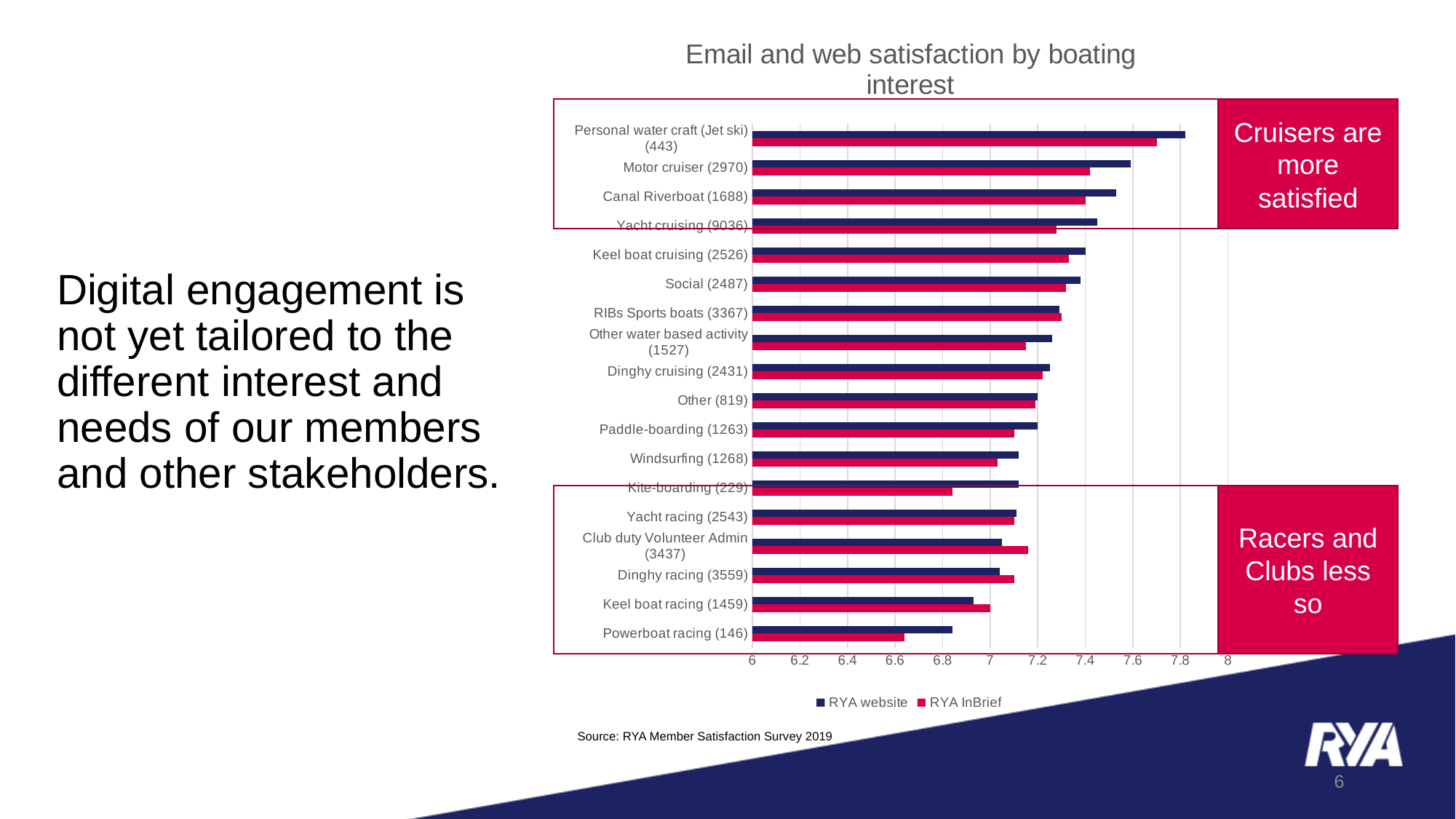
Is the RYA website value for Motor cruiser greater or less than 7.4? greater For Club duty Volunteer Admin, which series has the larger value, RYA website or RYA InBrief? RYA InBrief What is the title of the chart? Email and web satisfaction by boating interest Is the RYA InBrief value for Powerboat racing greater or less than 6.8? less Which category has the lowest RYA InBrief satisfaction score? Powerboat racing (146) Which colour represents the RYA InBrief series in the chart? Red Which category has the highest RYA website satisfaction score? Personal water craft (Jet ski) (443) Is the RYA website value for Personal water craft (Jet ski) greater or less than 7.6? greater What type of chart is shown on the slide? Bar chart How many boating interest categories are plotted on the chart? 18 How many series does the chart legend list? 2 For Personal water craft (Jet ski), which series has the larger value, RYA website or RYA InBrief? RYA website